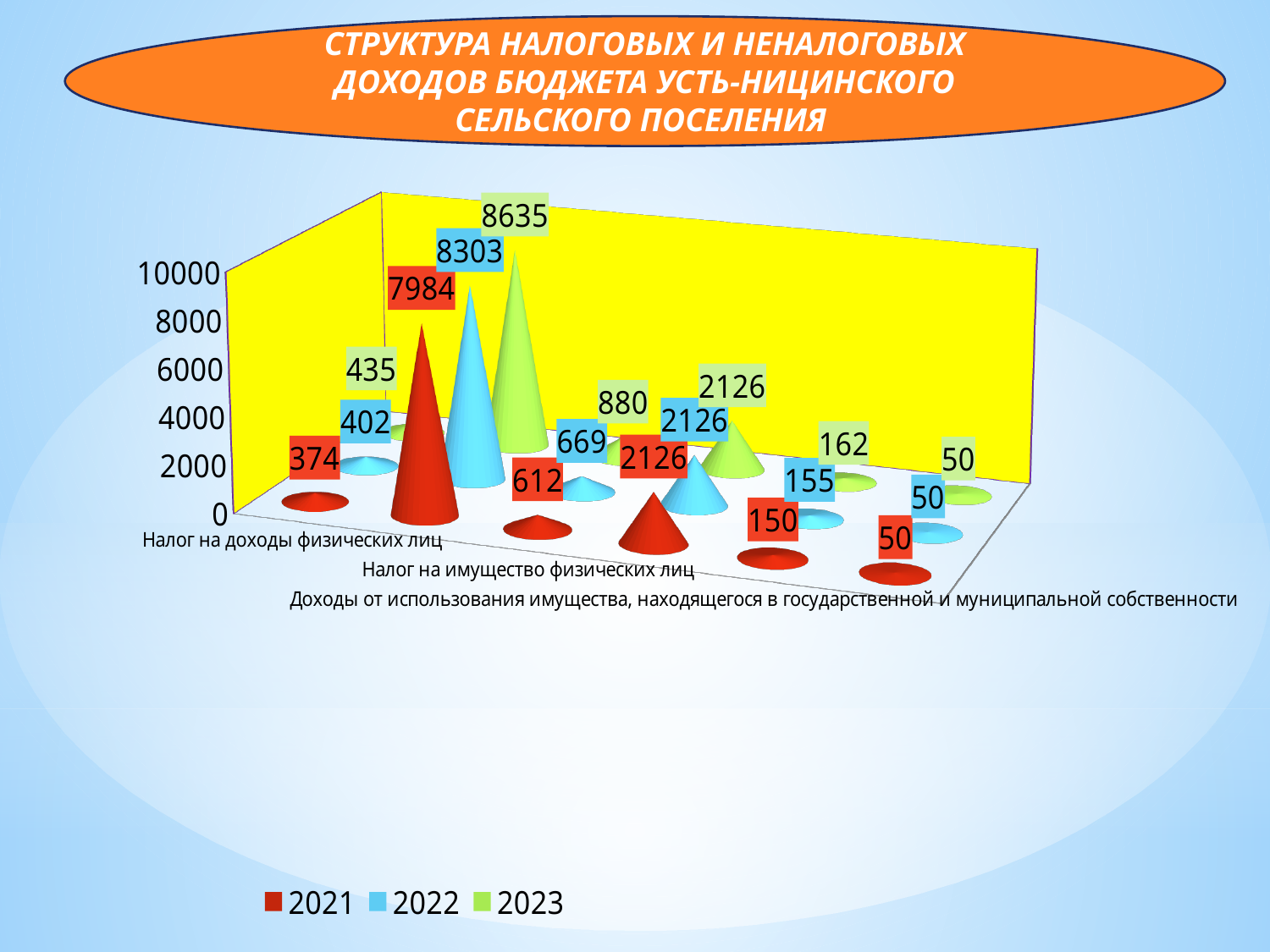
What is the 2023 value in the first group of cones from the left? 435 Which series has the highest labelled value on the chart? 2023 How many series does the legend list? 3 What is the difference between the 2023 and 2022 values in the second group of cones from the left? 332 What is the 2021 value in the second group of cones from the left? 7984 How many groups of cones are plotted on the chart? 6 What is the 2022 value in the second group of cones from the left? 8303 What is the maximum value shown on the vertical axis? 10000 In the third group of cones from the left, which is larger: the 2021 value or the 2022 value? 2022 Which years are listed in the legend? 2021, 2022, 2023 What value is labelled for all three years in the rightmost group of cones? 50 What is the highest value labelled anywhere on the chart? 8635